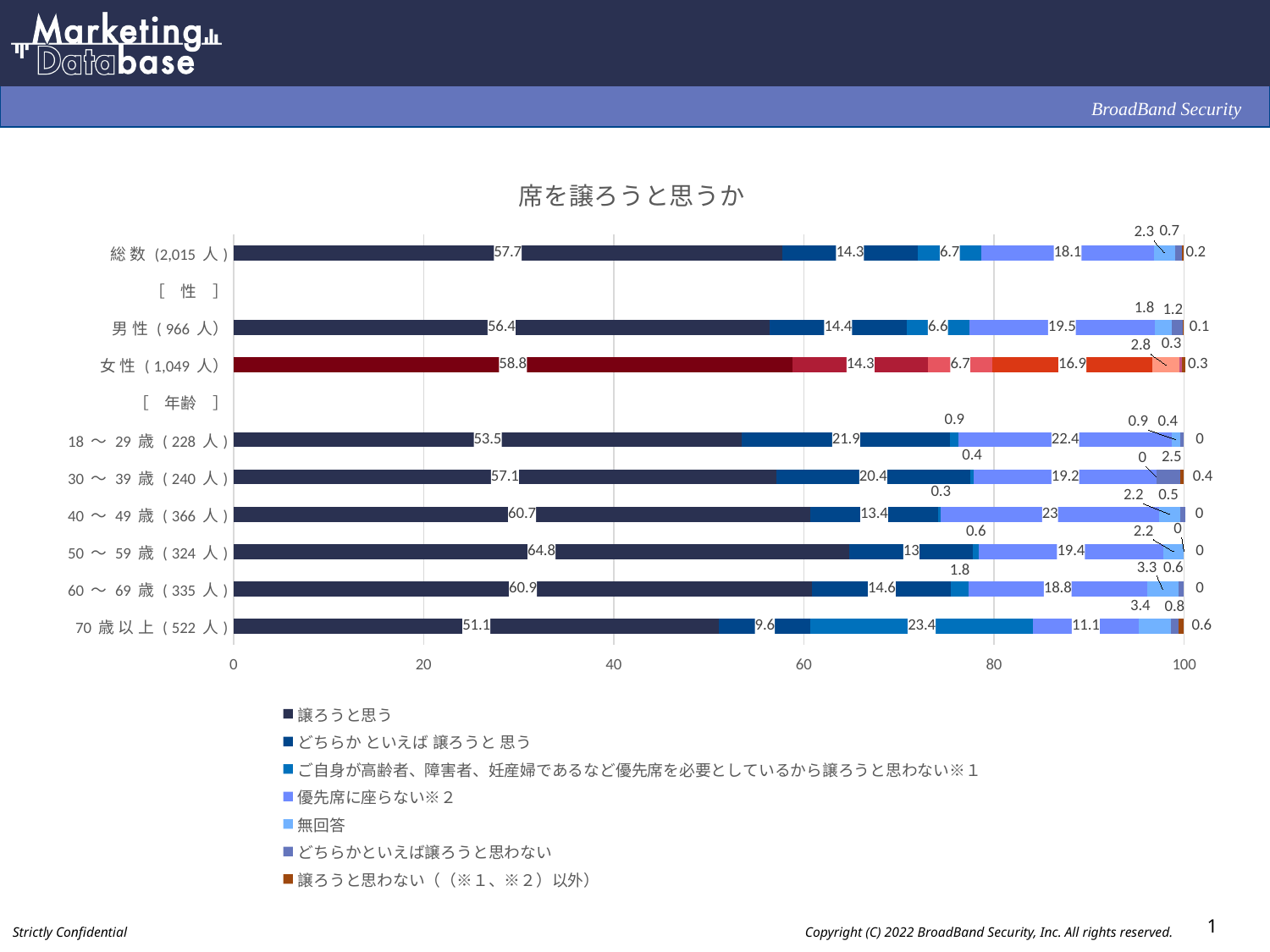
What is the difference between the 譲ろうと思う values for 女性 (1,049人) and 男性 (966人)? 2.4 What is the title of the chart? 席を譲ろうと思うか How many series does the legend list? 7 How many categories have bars plotted in the chart? 9 What type of chart is shown on the slide? stacked bar chart What is the value of 優先席に座らない※2 for 女性 (1,049人)? 16.9 Which category has the lowest value for 譲ろうと思う? 70歳以上 (522人) Which category has the highest value for 譲ろうと思う? 50〜59歳 (324人) Is the 譲ろうと思う value for 60〜69歳 (335人) greater or less than 60? greater What is the value of ご自身が高齢者、障害者、妊産婦であるなど優先席を必要としているから譲ろうと思わない※1 for 70歳以上 (522人)? 23.4 What is the value of 譲ろうと思う for 総数 (2,015人)? 57.7 Which is larger, the どちらかといえば譲ろうと思う value for 18〜29歳 (228人) or for 40〜49歳 (366人)? 18〜29歳 (228人)